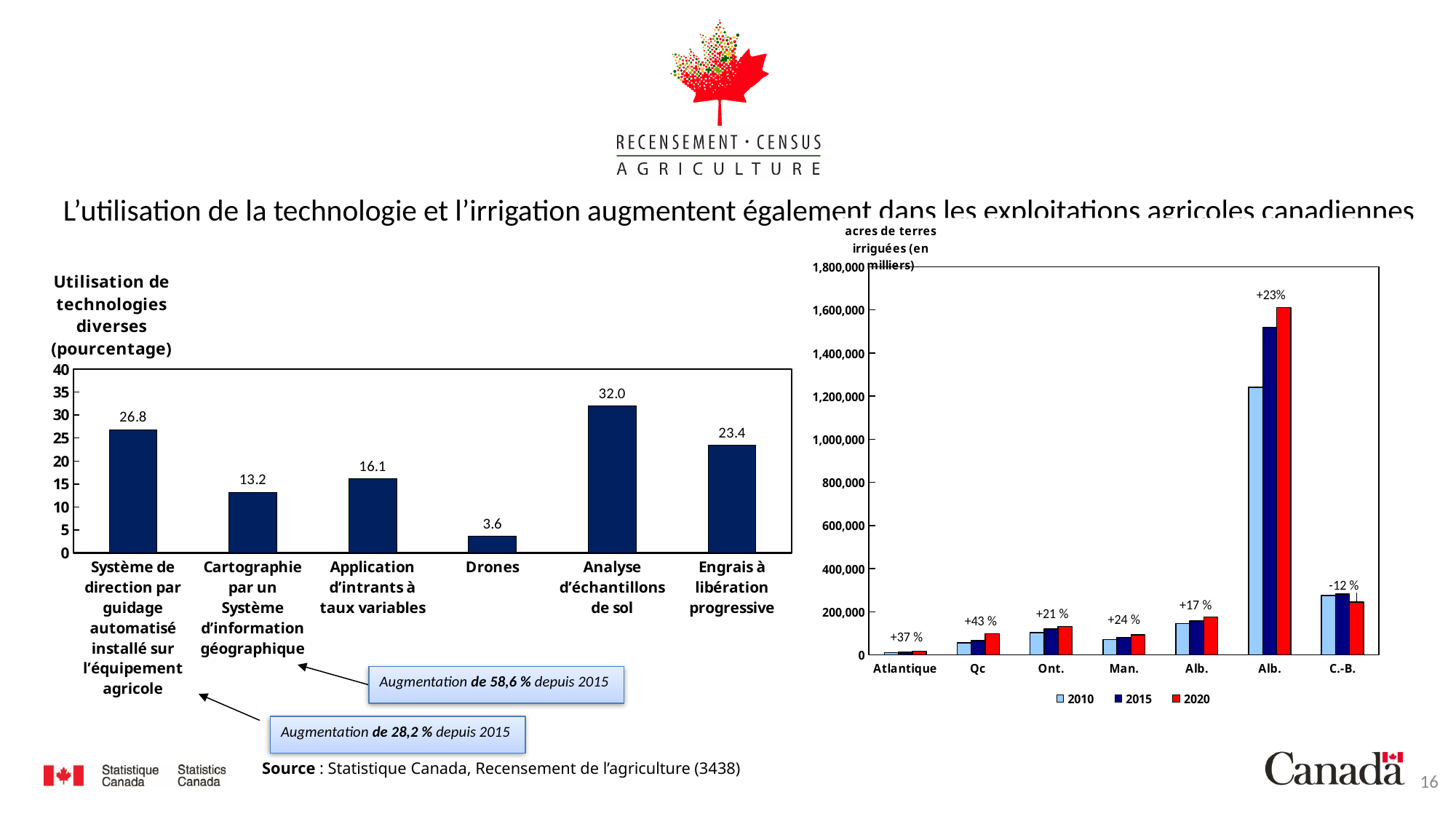
In the left chart (Utilisation de technologies diverses), what is the value for Drones? 3.6 In the right chart (acres de terres irriguées), what percentage change is printed above the bars for Qc? +43 % What kind of chart is the left chart (Utilisation de technologies diverses)? Bar chart In the left chart (Utilisation de technologies diverses), which category has the lowest value? Drones How many categories are shown in the left chart (Utilisation de technologies diverses)? 6 In the right chart (acres de terres irriguées), is the 2020 value for C.-B. greater or less than 400,000? less In the left chart (Utilisation de technologies diverses), which category has the highest value? Analyse d'échantillons de sol How many categories are shown on the x axis of the right chart (acres de terres irriguées)? 7 What are the legend entries of the right chart (acres de terres irriguées)? 2010, 2015, 2020 In the left chart (Utilisation de technologies diverses), which is larger: Cartographie par un Système d'information géographique or Application d'intrants à taux variables? Application d'intrants à taux variables How many series does the legend of the right chart (acres de terres irriguées) list? 3 In the left chart (Utilisation de technologies diverses), what is the difference between the value for Analyse d'échantillons de sol and the value for Système de direction par guidage automatisé installé sur l'équipement agricole? 5.2